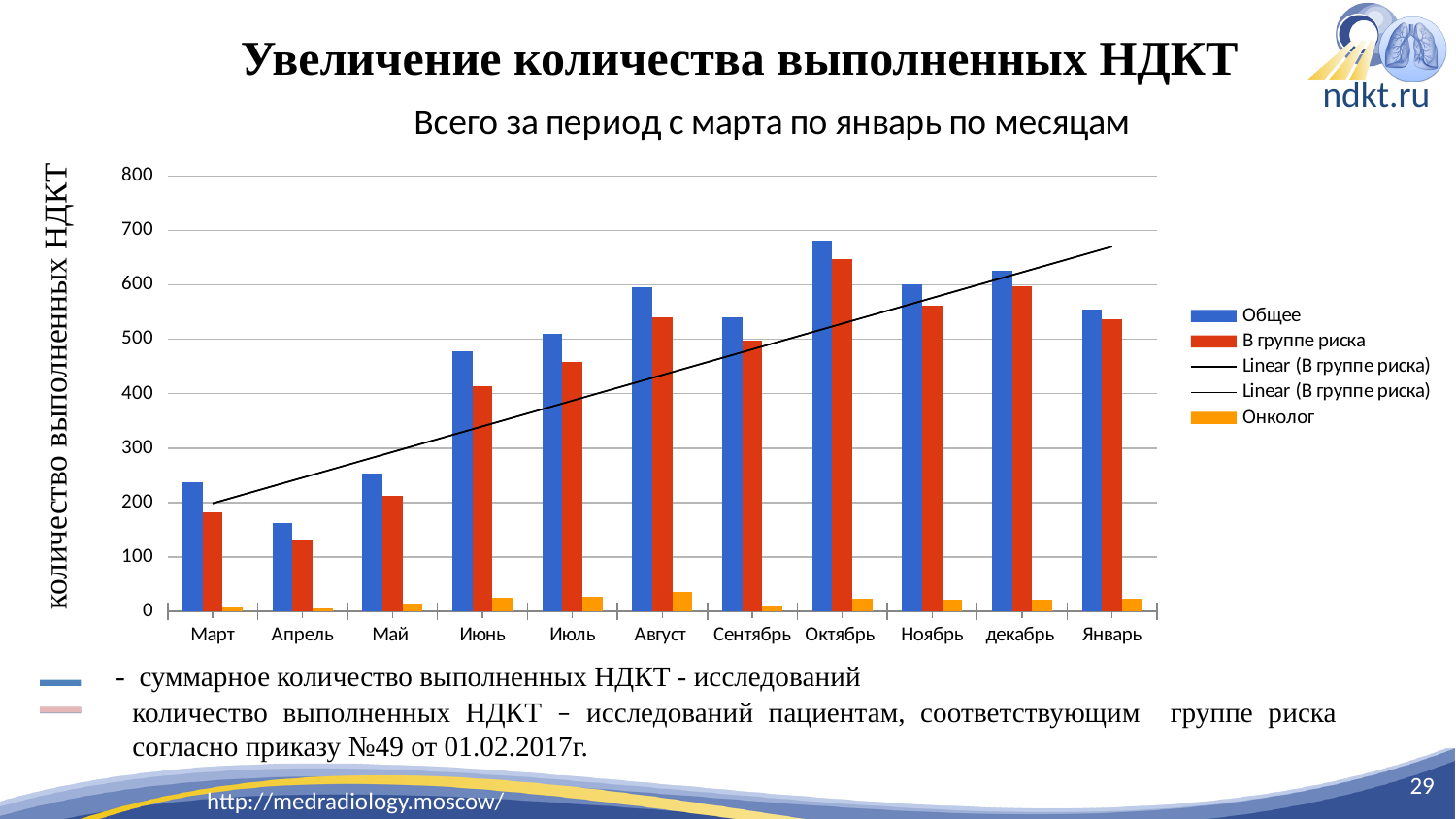
Is the value for Онколог in Август greater or less than 100? less How many months are shown on the x axis of the chart? 11 How many entries does the chart legend list? 5 Does the linear trend line for В группе риска rise or fall from Март to Январь? rise In which month is the value for Общее the highest? Октябрь Is the value for Общее in Октябрь greater or less than 600? greater Is the value for Общее in Июнь greater or less than 400? greater What kind of chart is shown on the slide? bar chart In which month is the value for В группе риска the highest? Октябрь In which month is the value for Общее the lowest? Апрель Which is larger, the value for Общее in Июнь or in Август? Август